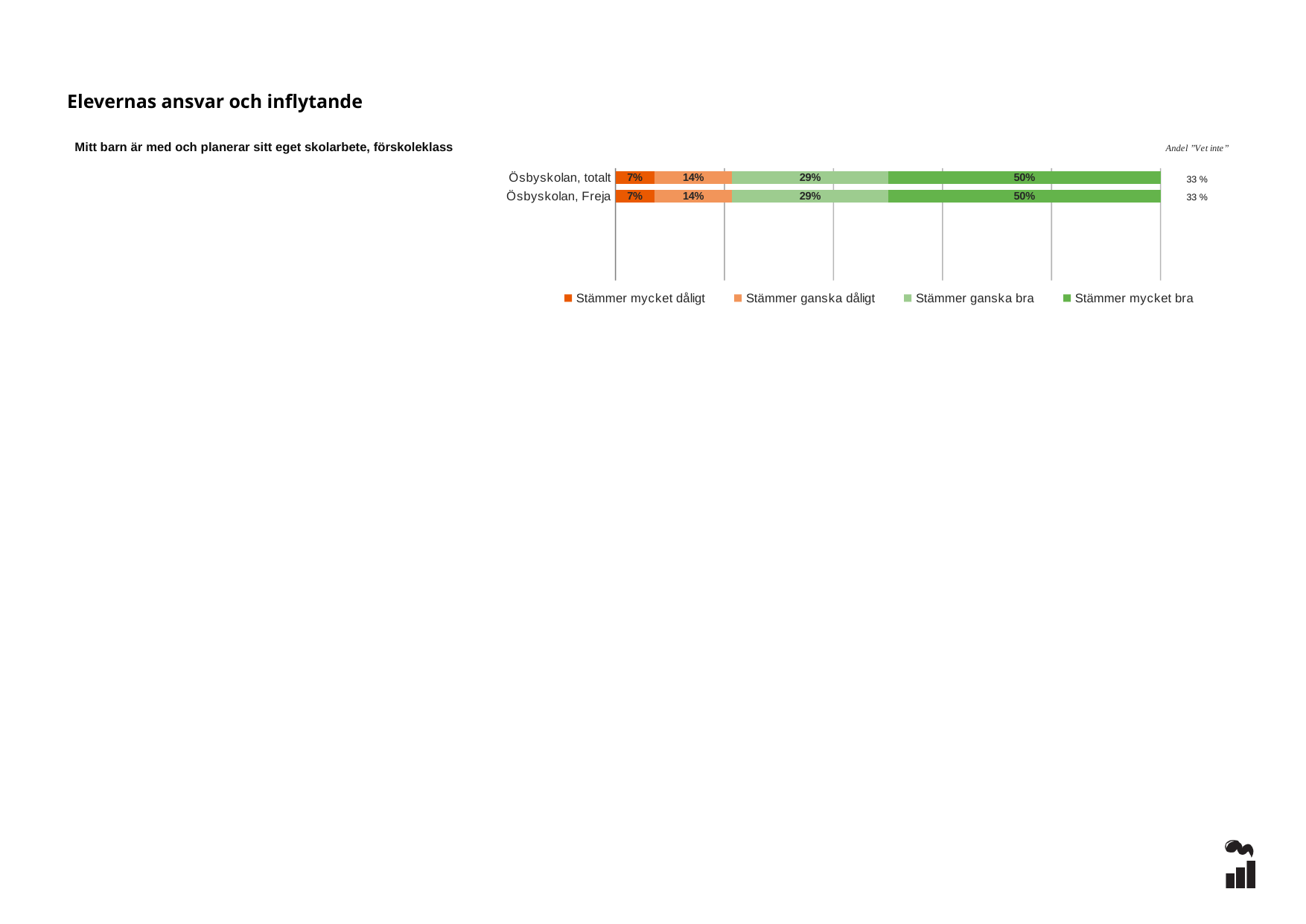
Which series has the smallest share in the Ösbyskolan, Freja bar? Stämmer mycket dåligt What is the combined share of "Stämmer ganska bra" and "Stämmer mycket bra" for Ösbyskolan, Freja? 79% What kind of chart is shown on the slide? Stacked bar chart How many categories (bars) are plotted in the chart? 2 What is the difference between "Stämmer mycket bra" and "Stämmer ganska bra" for Ösbyskolan, totalt? 21% What is the "Andel Vet inte" value shown next to the Ösbyskolan, totalt bar? 33 % Which series has the largest share in the Ösbyskolan, totalt bar? Stämmer mycket bra What is the value of "Stämmer ganska bra" for Ösbyskolan, Freja? 29% What is the value of "Stämmer mycket dåligt" for Ösbyskolan, Freja? 7% How many series does the legend list? 4 What is the value of "Stämmer mycket bra" for Ösbyskolan, totalt? 50% What is the value of "Stämmer ganska dåligt" for Ösbyskolan, totalt? 14%